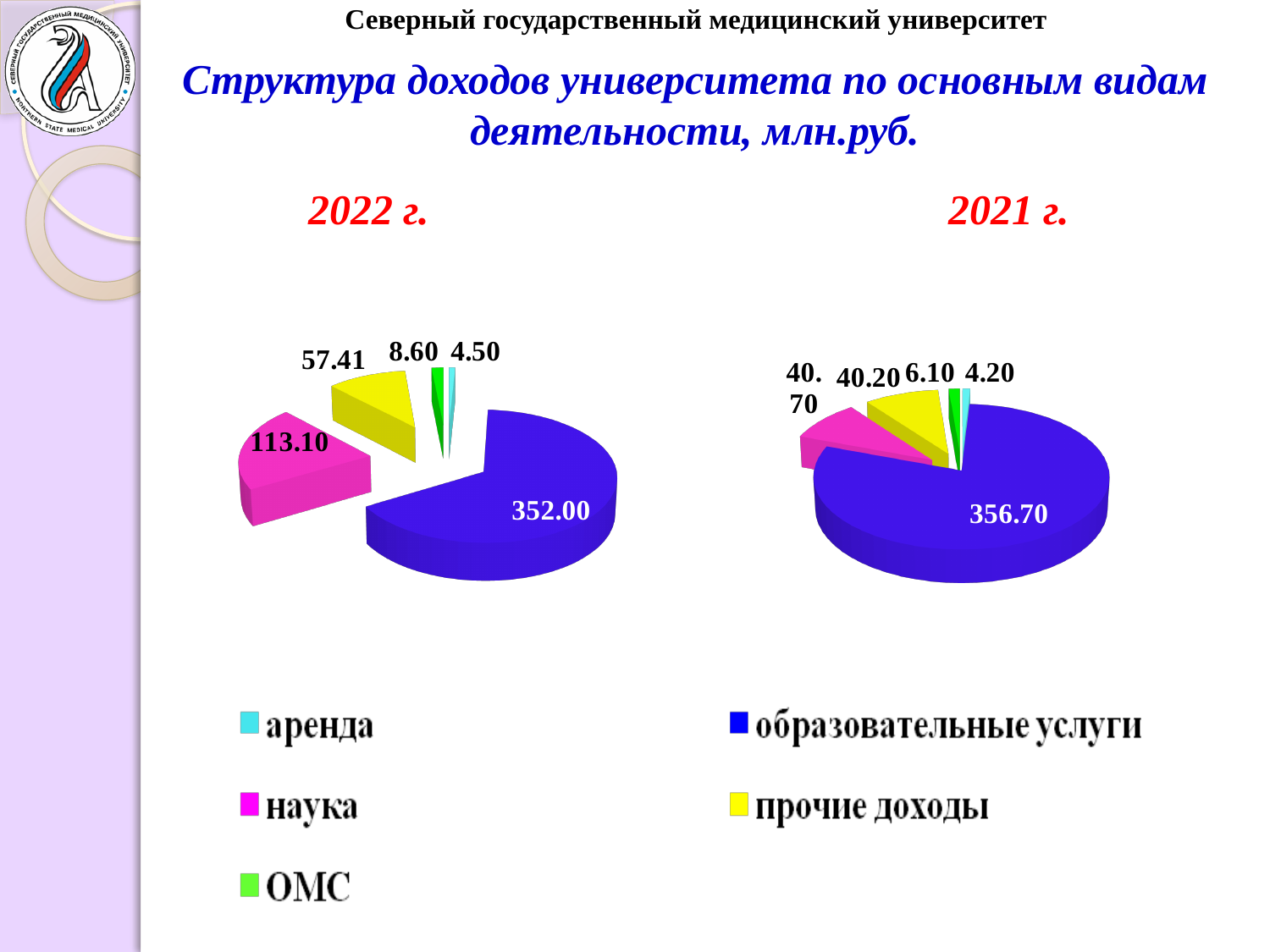
In the 2021 pie chart, what is the value for аренда? 4.20 What is the difference between ОМС and аренда in the 2022 pie chart? 4.10 Which is larger: образовательные услуги in the 2022 pie chart or in the 2021 pie chart? 2021 (356.70) In the 2022 pie chart, what is the value for образовательные услуги? 352.00 In the 2021 pie chart, which category has the smallest slice? аренда In the 2022 pie chart, what is the value for прочие доходы? 57.41 Which colour represents прочие доходы in the legend? yellow In the 2022 pie chart, which category has the largest slice? образовательные услуги How many slices does the 2022 pie chart have? 5 What type of chart is used for the 2021 data? pie chart In the 2021 pie chart, what is the value for наука? 40.70 What is the difference between the наука values in the 2022 and 2021 pie charts? 72.40